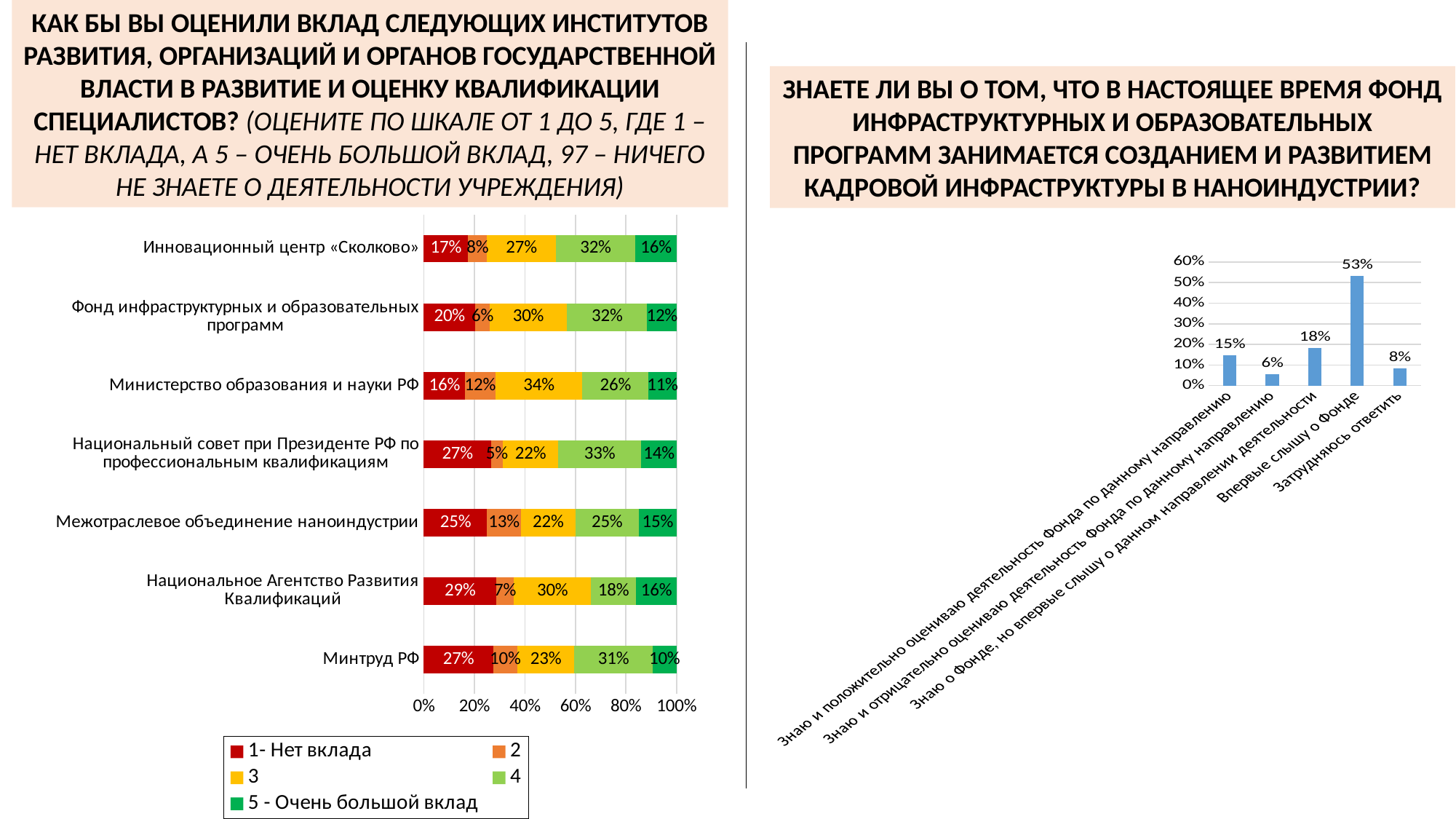
In the left chart, what is the difference between the rating-3 share for «Фонд инфраструктурных и образовательных программ» and for «Межотраслевое объединение наноиндустрии»? 8% What type of chart is shown on the right side of the slide? Bar chart In the left chart, which institution has the highest share of «1- Нет вклада» responses? Национальное Агентство Развития Квалификаций In the right chart, which answer option has the lowest value? Знаю и отрицательно оцениваю деятельность Фонда по данному направлению In the left chart, what share of respondents chose «1- Нет вклада» for «Национальное Агентство Развития Квалификаций»? 29% In the left chart, how many institutions are listed? 7 In the left chart, which institution has the lowest share of «5 - Очень большой вклад» responses? Минтруд РФ In the left chart, what percentage of respondents gave «Инновационный центр «Сколково»» a rating of 4? 32% In the right chart, which is larger: «Знаю и положительно оцениваю деятельность Фонда по данному направлению» or «Знаю о Фонде, но впервые слышу о данном направлении деятельности»? Знаю о Фонде, но впервые слышу о данном направлении деятельности In the left chart, how many series does the legend list? 5 In the right chart, what percentage of respondents chose «Впервые слышу о Фонде»? 53% In the left chart, what percentage gave «Министерство образования и науки РФ» a rating of 3? 34%